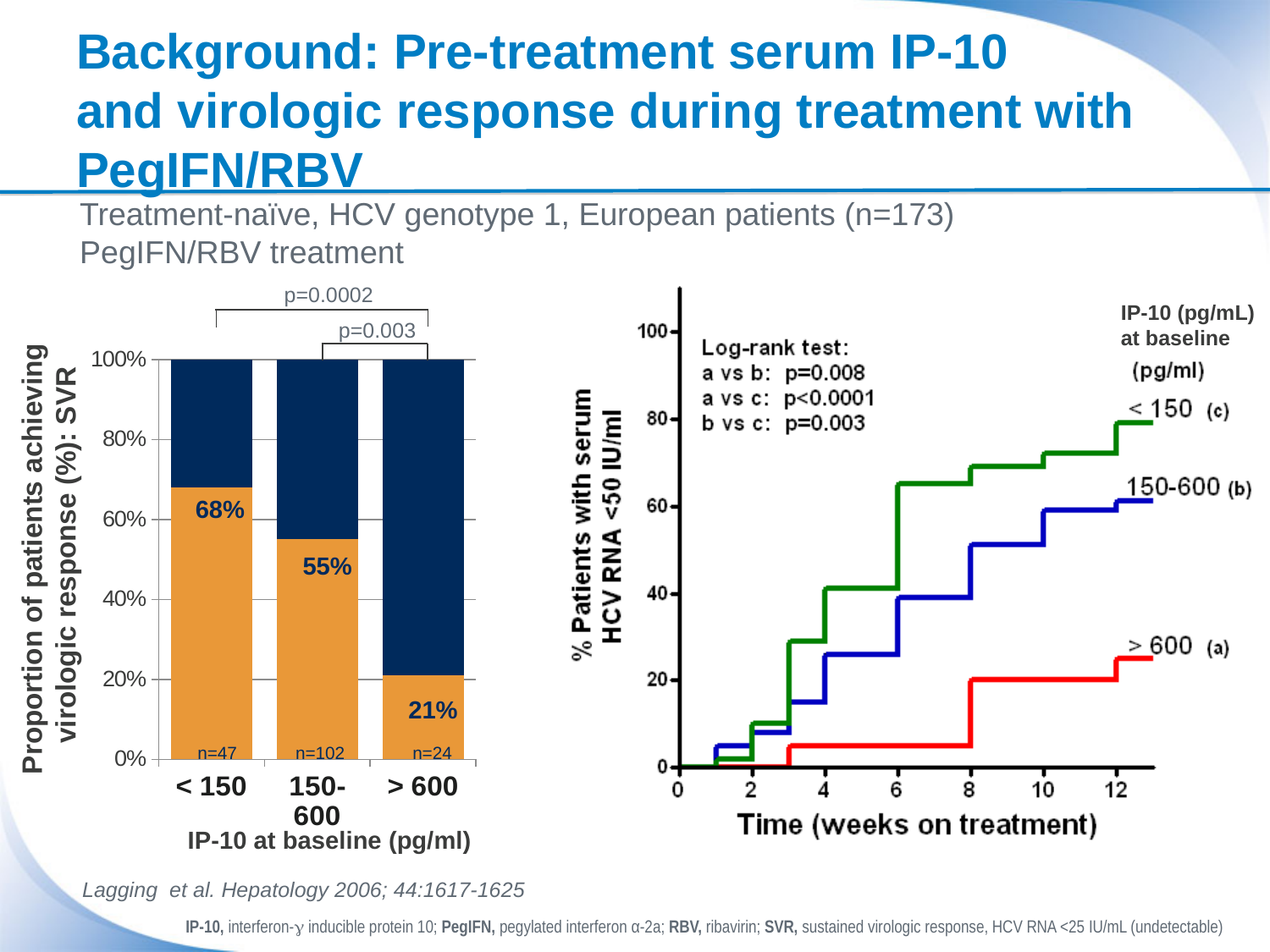
What kind of chart is the left chart on the slide? Stacked bar chart In the right chart, is the value for the > 600 (a) group at week 8 greater or less than 40? less In the left bar chart, how many baseline IP-10 categories are shown? 3 In the left bar chart, which baseline IP-10 group has the highest SVR rate? < 150 In the right chart, which baseline IP-10 group reaches the highest percentage of patients with HCV RNA <50 IU/ml by week 12? < 150 (c) In the left bar chart, how many patients were in the 150-600 pg/ml group? n=102 In the left bar chart, what proportion of patients with baseline IP-10 of 150-600 pg/ml achieved SVR? 55% In the left bar chart, what proportion of patients with baseline IP-10 > 600 pg/ml achieved SVR? 21% In the left bar chart, what proportion of patients with baseline IP-10 < 150 pg/ml achieved SVR? 68% In the left bar chart, what p-value is shown for the comparison between the < 150 and > 600 groups? p=0.0002 In the left bar chart, which baseline IP-10 group has the lowest SVR rate? > 600 In the left bar chart, what is the difference in SVR rate between the < 150 group and the > 600 group? 47%